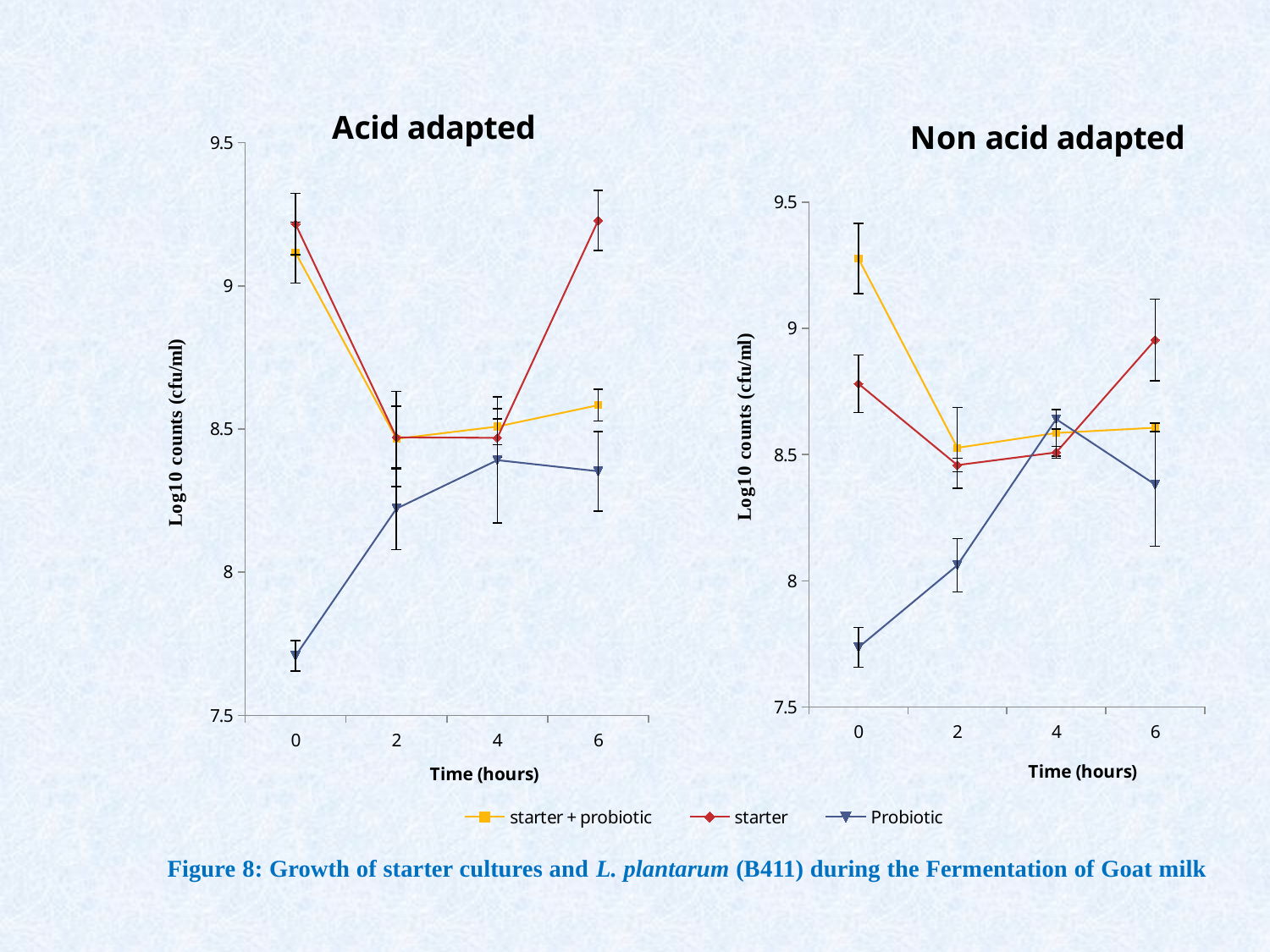
What is the y-axis label of the 'Acid adapted' chart? Log10 counts (cfu/ml) In the 'Non acid adapted' chart, is the value for Probiotic at 6 hours greater or less than 8.5? less In the 'Non acid adapted' chart, which series has the lowest value at 0 hours? Probiotic In the 'Acid adapted' chart, which is larger at 6 hours: starter or starter + probiotic? starter In the 'Non acid adapted' chart, does the starter + probiotic series rise or fall between 0 and 2 hours? fall What kind of chart is the 'Acid adapted' chart? line chart In the 'Acid adapted' chart, is the value for starter at 6 hours greater or less than 9? greater In the 'Acid adapted' chart, is the value for Probiotic at 0 hours greater or less than 8? less In the 'Non acid adapted' chart, how many time points are plotted on the x axis? 4 In the 'Acid adapted' chart, does the Probiotic series rise or fall between 0 and 4 hours? rise How many series does the legend list? 3